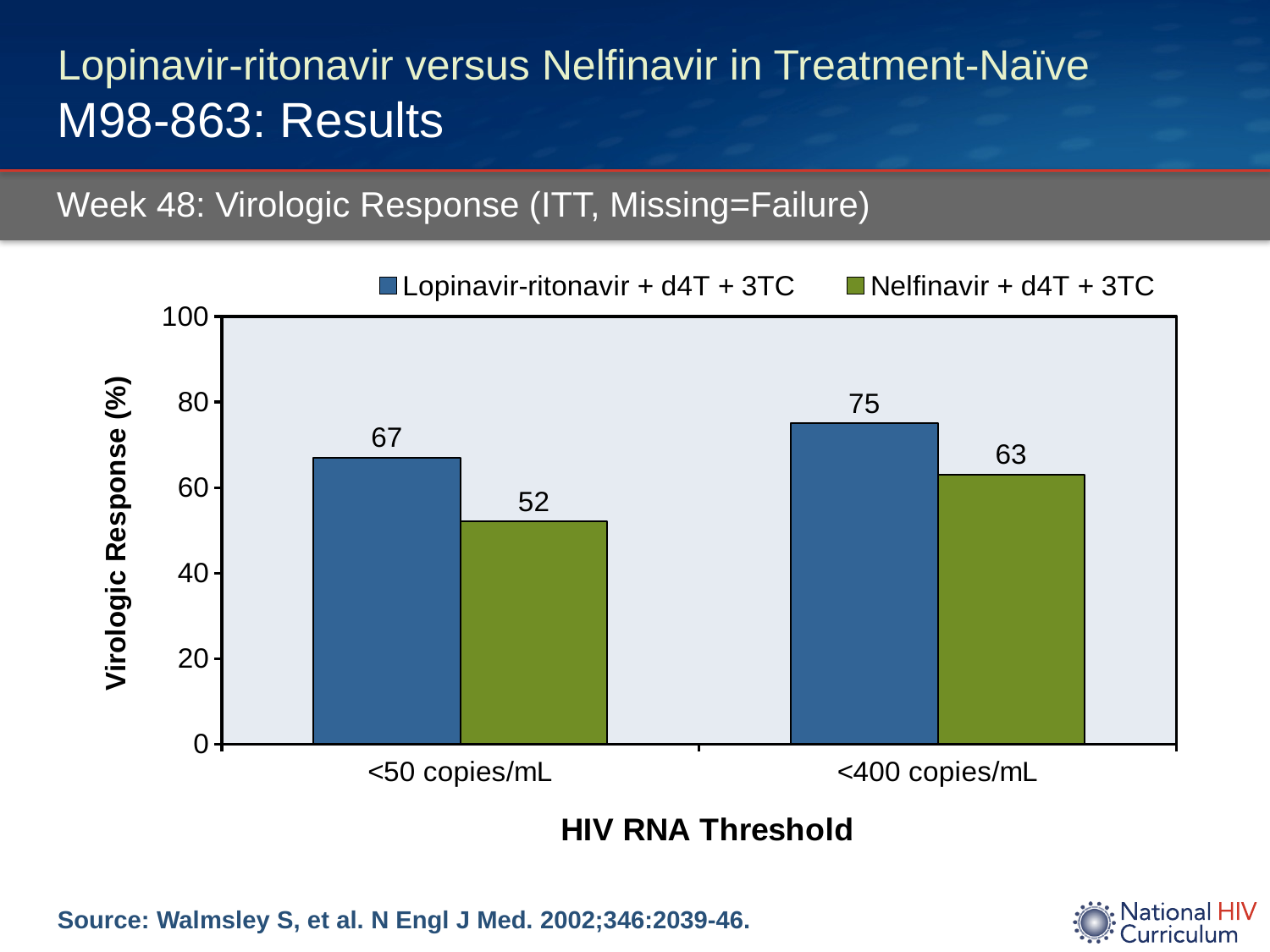
At the <400 copies/mL threshold, which regimen has the larger virologic response? Lopinavir-ritonavir + d4T + 3TC What kind of chart is shown on the slide? Bar chart What is the virologic response for Nelfinavir + d4T + 3TC at the <400 copies/mL threshold? 63 What is the virologic response for Lopinavir-ritonavir + d4T + 3TC at the <50 copies/mL threshold? 67 Which bar has the highest value on the chart? Lopinavir-ritonavir + d4T + 3TC at <400 copies/mL What is the virologic response for Nelfinavir + d4T + 3TC at the <50 copies/mL threshold? 52 How many series does the legend list? 2 How many HIV RNA threshold categories are shown on the x axis? 2 What is the difference between the Lopinavir-ritonavir + d4T + 3TC and Nelfinavir + d4T + 3TC values at the <400 copies/mL threshold? 12 What is the difference between the Lopinavir-ritonavir + d4T + 3TC and Nelfinavir + d4T + 3TC values at the <50 copies/mL threshold? 15 What is the virologic response for Lopinavir-ritonavir + d4T + 3TC at the <400 copies/mL threshold? 75 Which bar has the lowest value on the chart? Nelfinavir + d4T + 3TC at <50 copies/mL